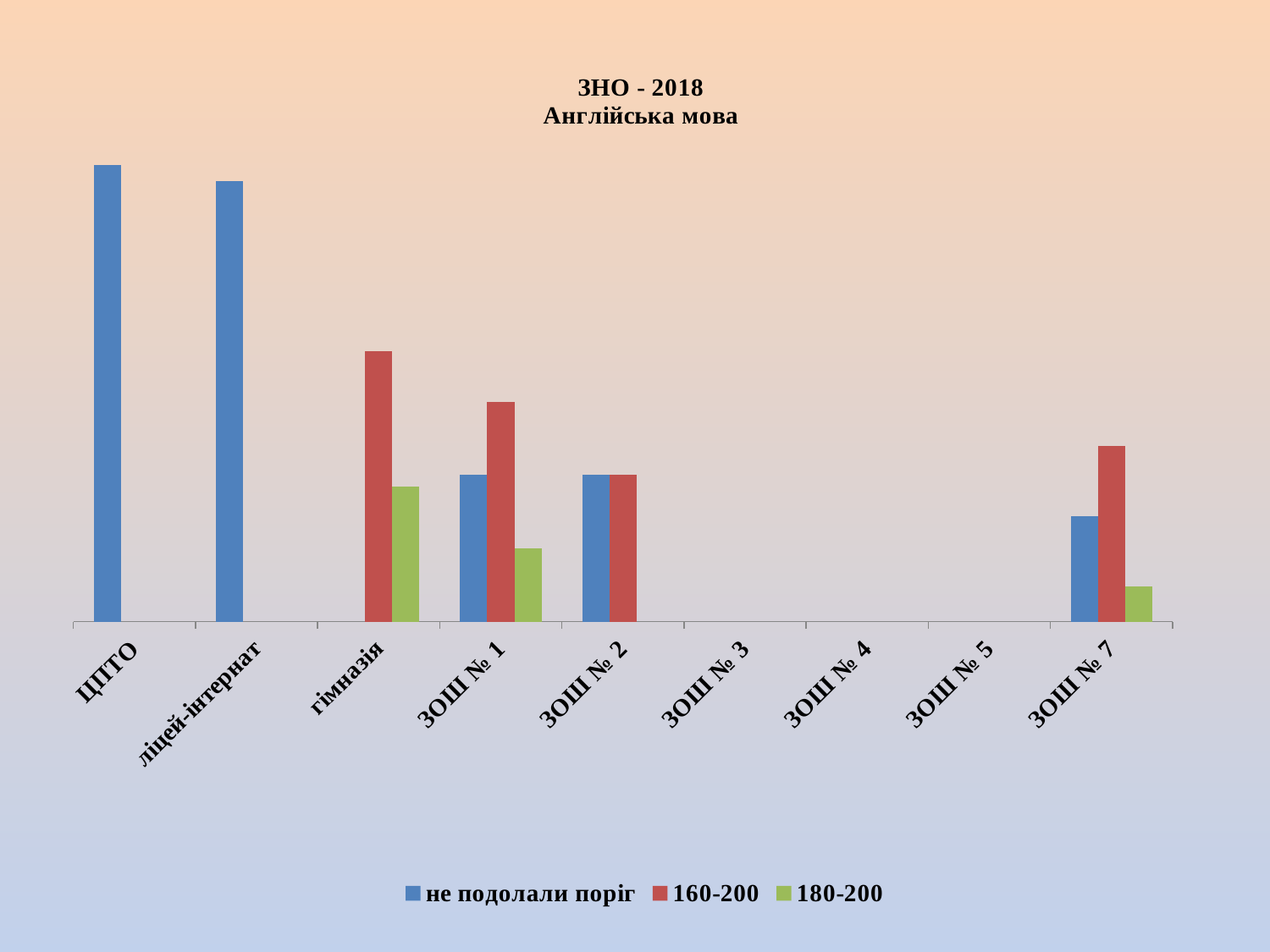
Among the categories that have a "180-200" bar, which one has the lowest? ЗОШ № 7 Which category has the highest bar for the series "160-200"? гімназія For гімназія, which series has the larger bar: "160-200" or "180-200"? 160-200 For ЗОШ № 1, which series has the larger bar: "не подолали поріг" or "160-200"? 160-200 What kind of chart is shown on the slide? bar chart How many series does the legend list? 3 What is the title of the chart? ЗНО - 2018 Англійська мова Which category has the highest bar for the series "180-200"? гімназія How many categories (schools) are listed along the x axis? 9 How many categories on the x axis have no bars at all? 3 For ЗОШ № 7, which series has the larger bar: "не подолали поріг" or "160-200"? 160-200 Which series is shown in blue according to the legend? не подолали поріг